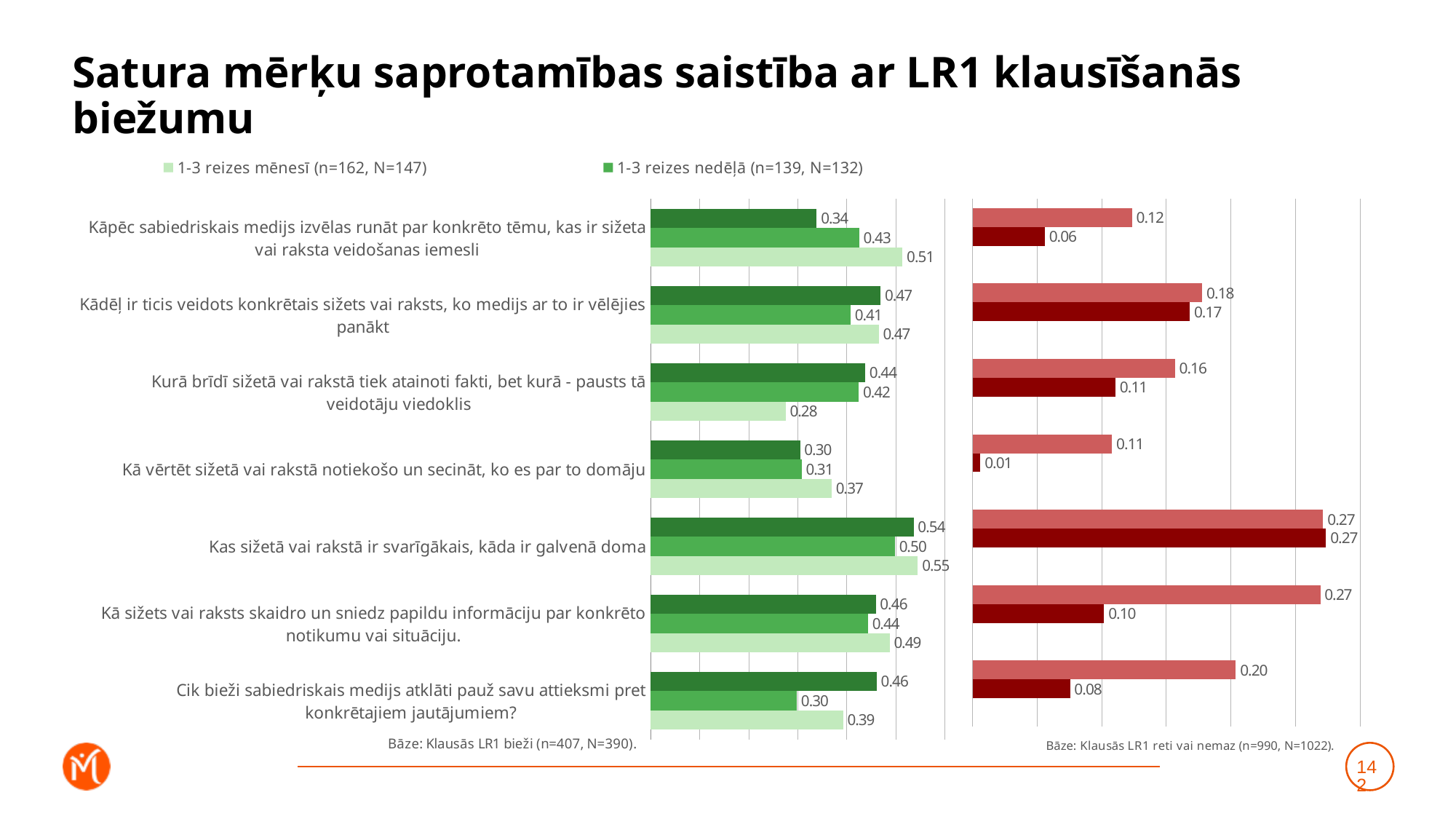
In the left chart, for 'Kā vērtēt sižetā vai rakstā notiekošo un secināt, ko es par to domāju', which series has the larger value: '1-3 reizes mēnesī' or '1-3 reizes nedēļā'? 1-3 reizes mēnesī In the left chart, what is the value of the '1-3 reizes nedēļā' bar for 'Cik bieži sabiedriskais medijs atklāti pauž savu attieksmi pret konkrētajiem jautājumiem?'? 0.30 In the right chart, what is the difference between the two bars for 'Kā sižets vai raksts skaidro un sniedz papildu informāciju par konkrēto notikumu vai situāciju.'? 0.17 In the left chart, for which category is the '1-3 reizes mēnesī' bar the lowest? Kurā brīdī sižetā vai rakstā tiek atainoti fakti, bet kurā - pausts tā veidotāju viedoklis In the left chart, what is the difference between the '1-3 reizes mēnesī' and '1-3 reizes nedēļā' values for 'Kāpēc sabiedriskais medijs izvēlas runāt par konkrēto tēmu, kas ir sižeta vai raksta veidošanas iemesli'? 0.08 How many series does the legend at the top of the slide list? 2 In the left chart, for which category is the '1-3 reizes mēnesī' bar the highest? Kas sižetā vai rakstā ir svarīgākais, kāda ir galvenā doma In the left chart, what is the value of the '1-3 reizes mēnesī' bar for 'Kas sižetā vai rakstā ir svarīgākais, kāda ir galvenā doma'? 0.55 How many categories (statements) are plotted in the left chart? 7 What kind of chart is shown on the left side of the slide? bar chart In the right chart, what is the smallest value labelled on any bar? 0.01 What base (Bāze) is stated below the left chart? Klausās LR1 bieži (n=407, N=390)